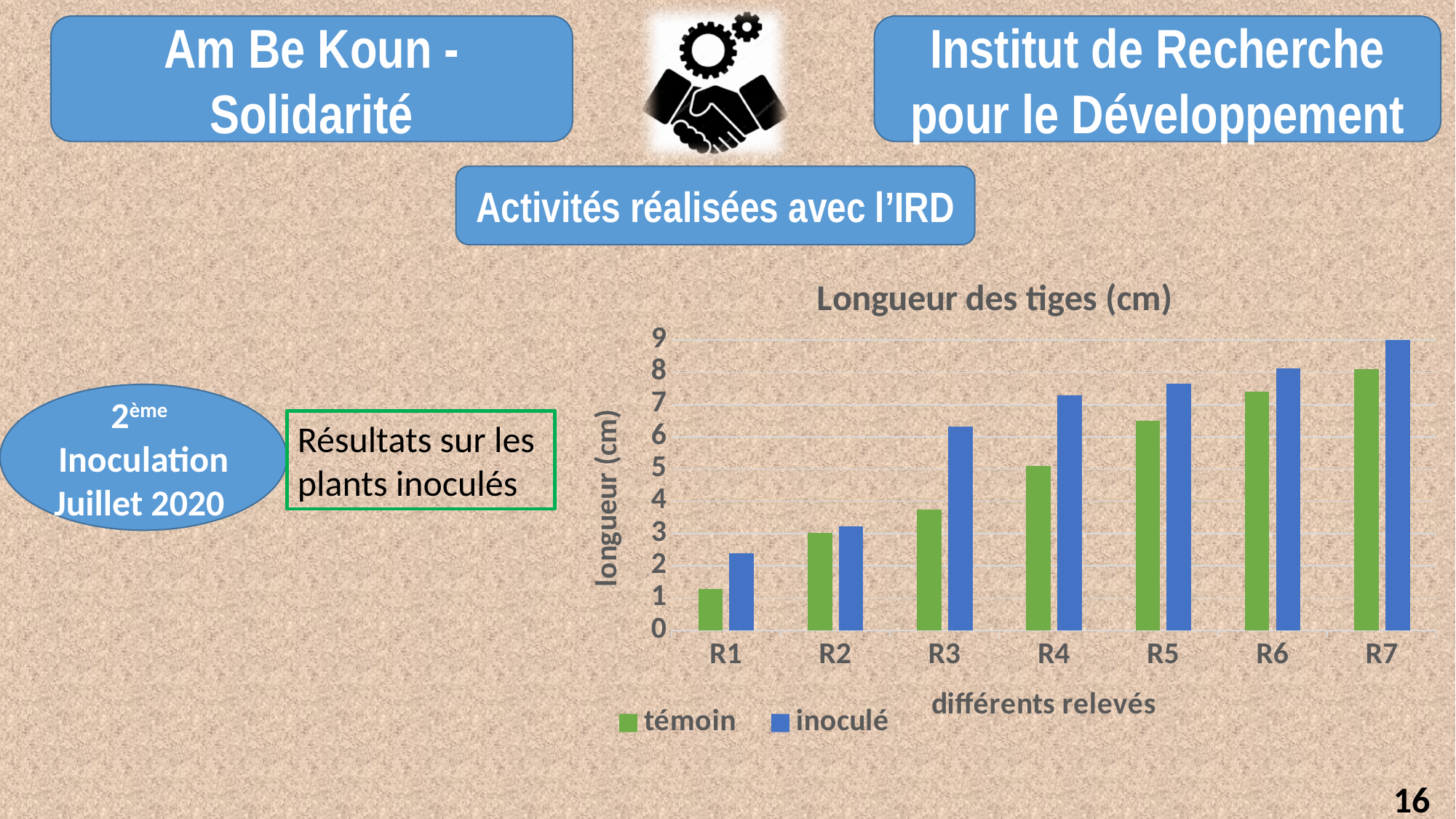
What kind of chart is shown on the slide? bar chart Is the inoculé value at R3 greater or less than 5? greater Which relevé has the highest value for the témoin series? R7 What is the title of the chart? Longueur des tiges (cm) How many relevés (categories) are shown on the x axis of the chart? 7 Which relevé has the lowest value for the témoin series? R1 Do the inoculé values rise or fall from R1 to R7? rise Which relevé has the lowest value for the inoculé series? R1 At R3, which series has the larger value, témoin or inoculé? inoculé Which relevé has the highest value for the inoculé series? R7 Is the témoin value at R1 greater or less than 2? less How many series does the chart's legend list? 2